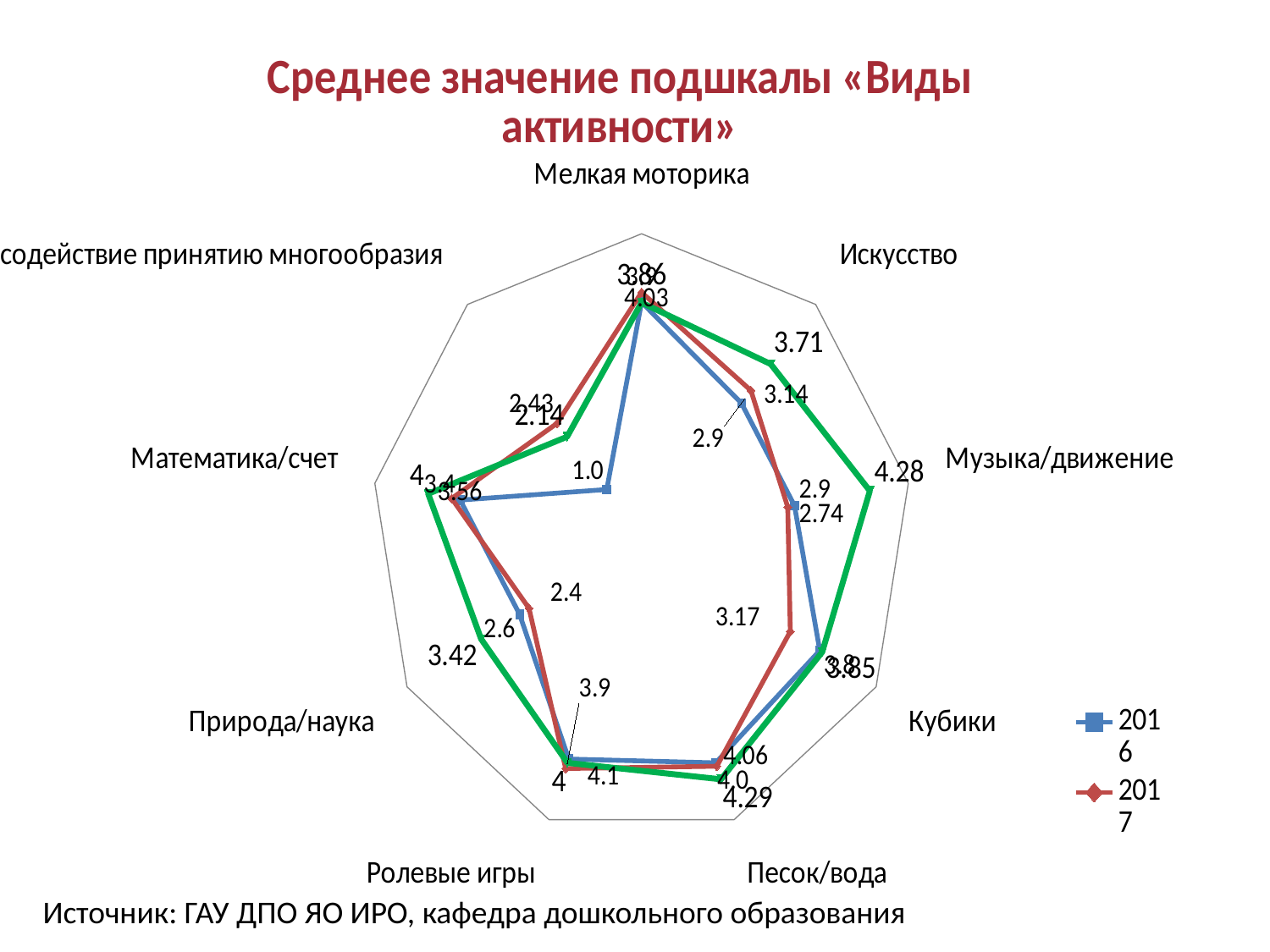
How many series does the legend list? 2 How many categories (axes) does the radar chart have? 9 What is the 2017 value for содействие принятию многообразия? 2.43 Which category has the lowest 2016 value? содействие принятию многообразия What is the 2017 value for Кубики? 3.17 What is the 2016 value for содействие принятию многообразия? 1.0 What is the 2017 value for Искусство? 3.14 What is the 2017 value for Природа/наука? 2.4 For Искусство, which year has the larger value, 2016 or 2017? 2017 What is the 2016 value for Музыка/движение? 2.9 By how much does the 2017 value for содействие принятию многообразия exceed the 2016 value? 1.43 What kind of chart is shown on the slide? radar chart